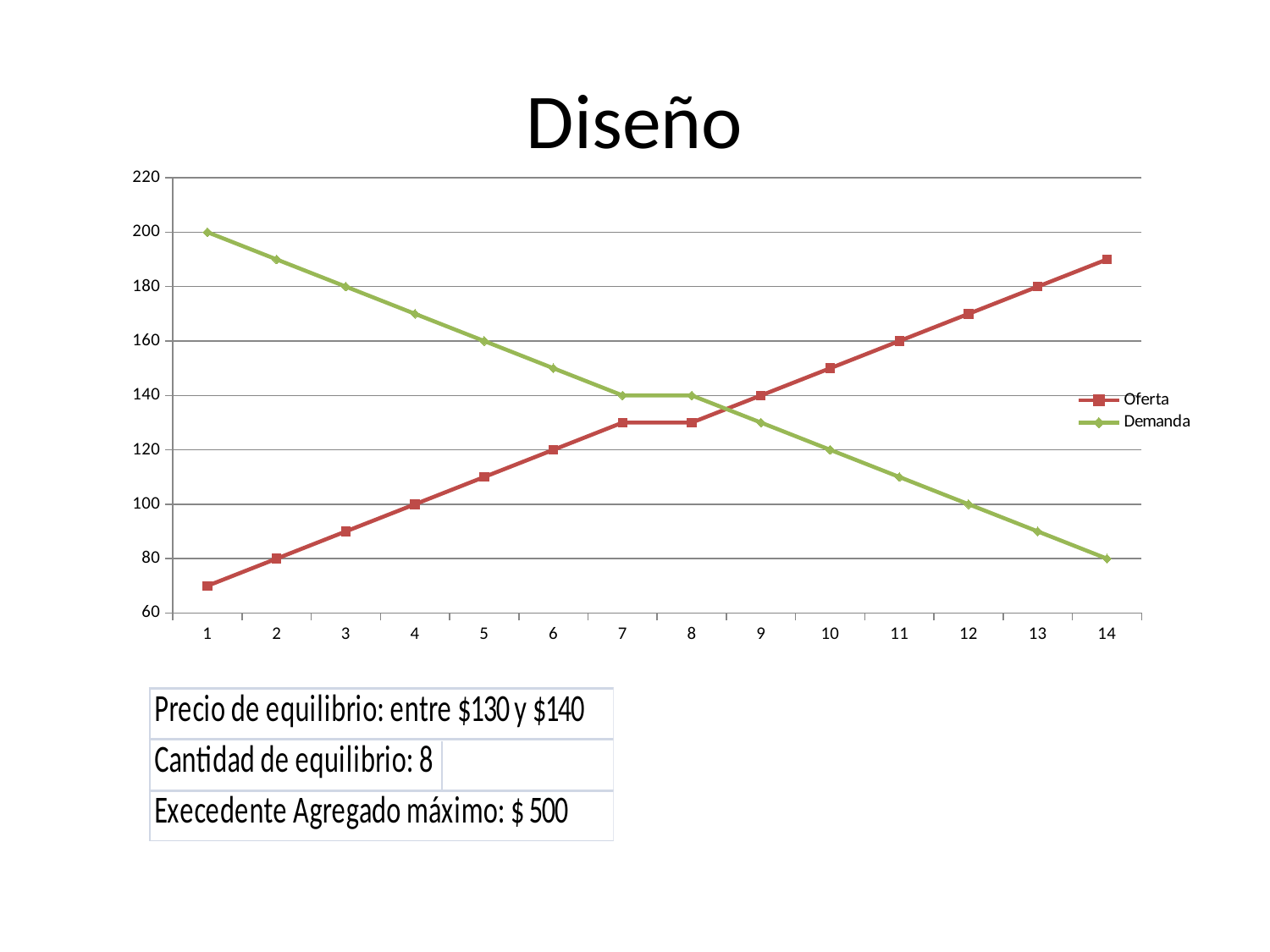
What kind of chart is shown on the slide? line chart What is the value of Demanda at x = 14? 80 Is the value of Oferta at x = 14 greater or less than 180? greater How many series does the legend list? 2 What is the difference between Demanda at x = 1 and Demanda at x = 14? 120 Is the value of Oferta at x = 1 greater or less than 80? less What is the value of Oferta at x = 6? 120 At which x value is Demanda lowest? 14 At which x value is Oferta highest? 14 How many points are plotted along the x axis for each series? 14 At x = 3, which series has the larger value, Oferta or Demanda? Demanda What is the value of Demanda at x = 1? 200